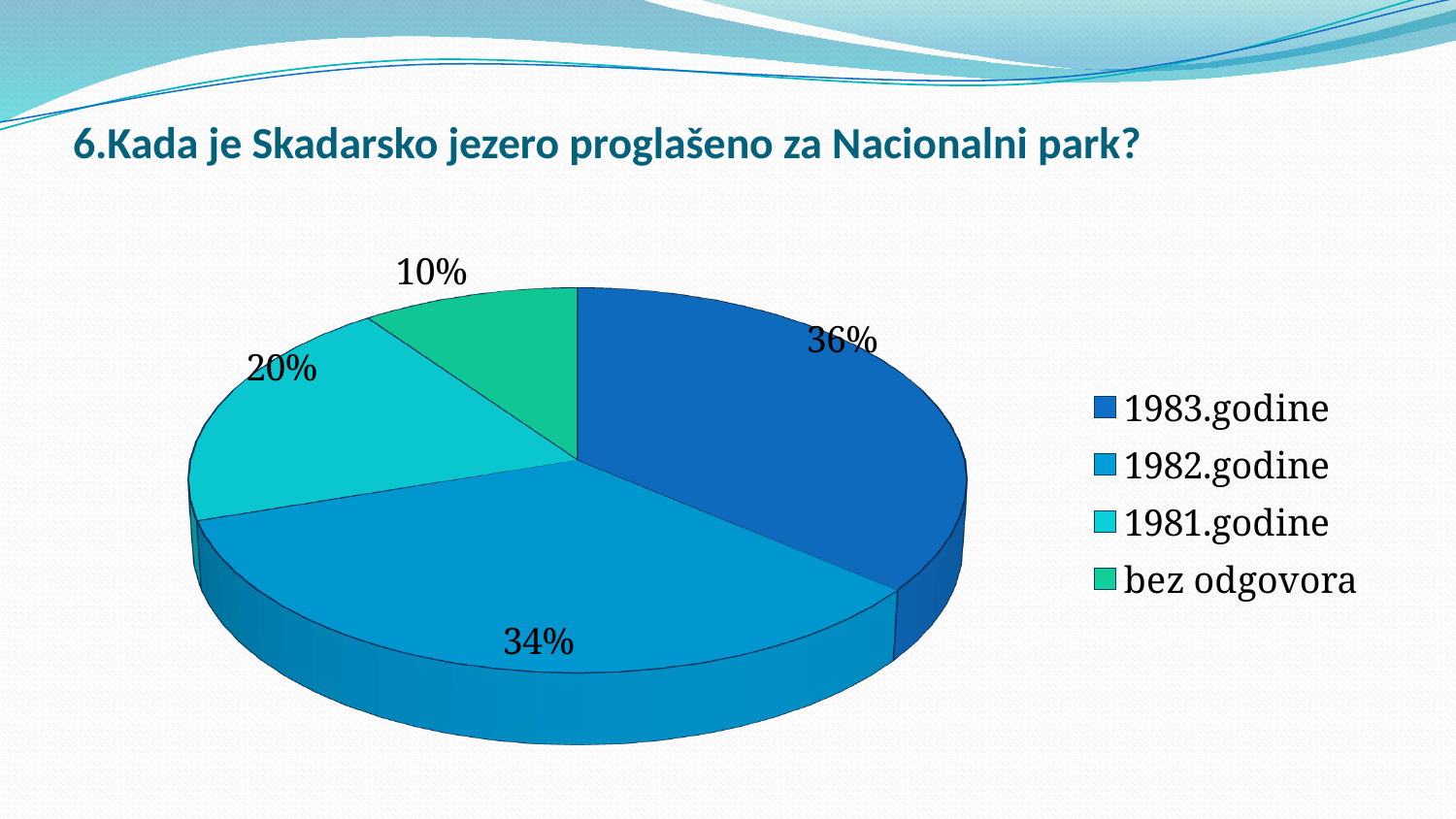
What percentage of the pie is for 1983.godine? 36% How many slices does the pie chart have? 4 What kind of chart is shown on the slide? pie chart Which is larger, the share for 1981.godine or the share for bez odgovora? 1981.godine What percentage of the pie is for 1981.godine? 20% What is the difference in percentage points between 1983.godine and 1982.godine? 2 What percentage of the pie is for 1982.godine? 34% Which category has the largest share of the pie? 1983.godine Which category has the smallest share of the pie? bez odgovora What percentage of the pie is for bez odgovora? 10% How many entries does the legend list? 4 What is the difference in percentage points between 1981.godine and bez odgovora? 10